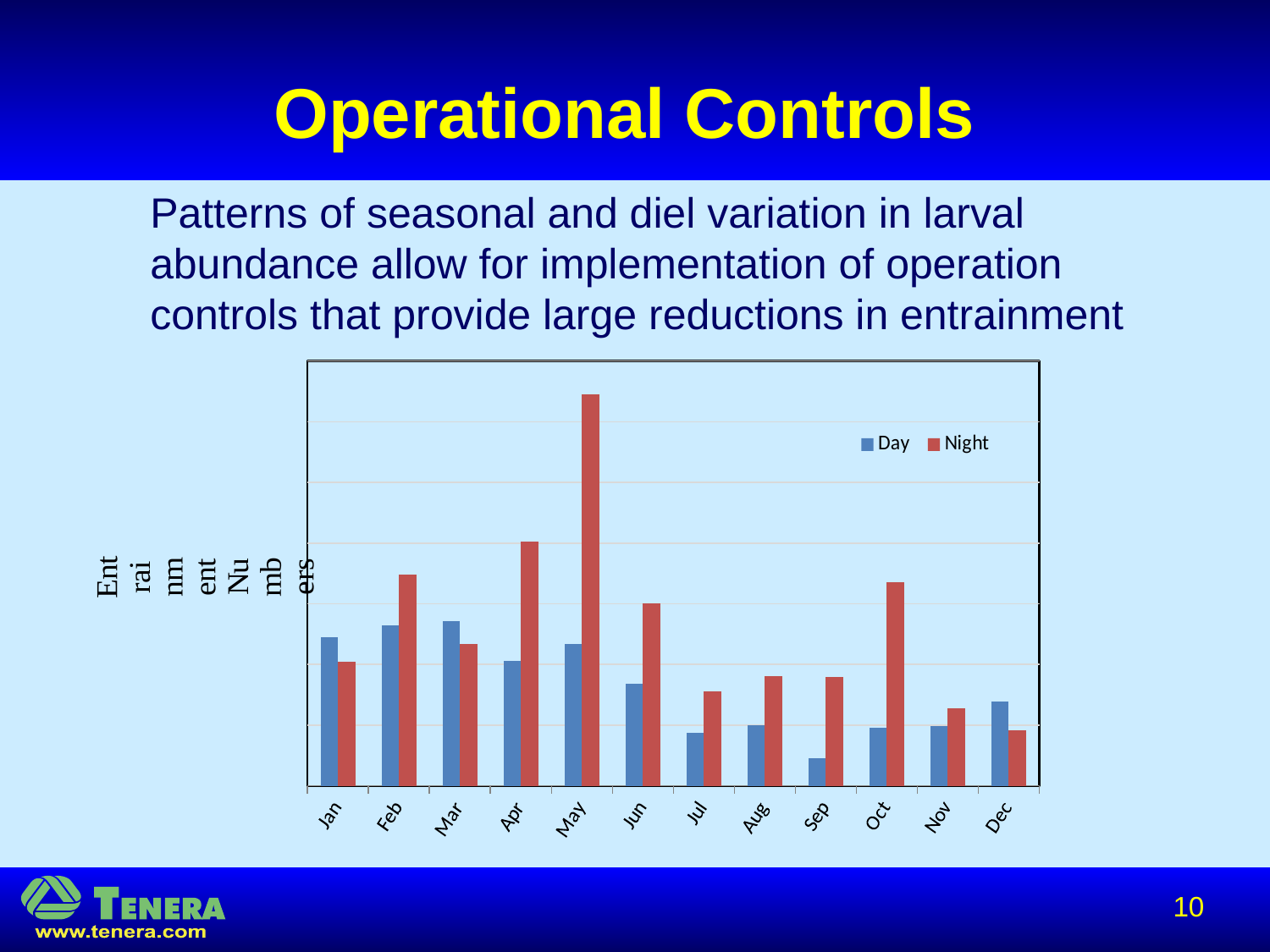
In Dec, which is larger, the Day value or the Night value? Day How many months are shown along the x axis of the chart? 12 Which month has the lowest Night value? Dec Which month has the lowest Day value? Sep What are the two series named in the chart's legend? Day and Night In Jan, which is larger, the Day value or the Night value? Day What colour are the bars for the Night series? red Which month has the highest Night value? May What kind of chart is shown on the slide? bar chart How many series does the chart's legend list? 2 In May, which is larger, the Day value or the Night value? Night